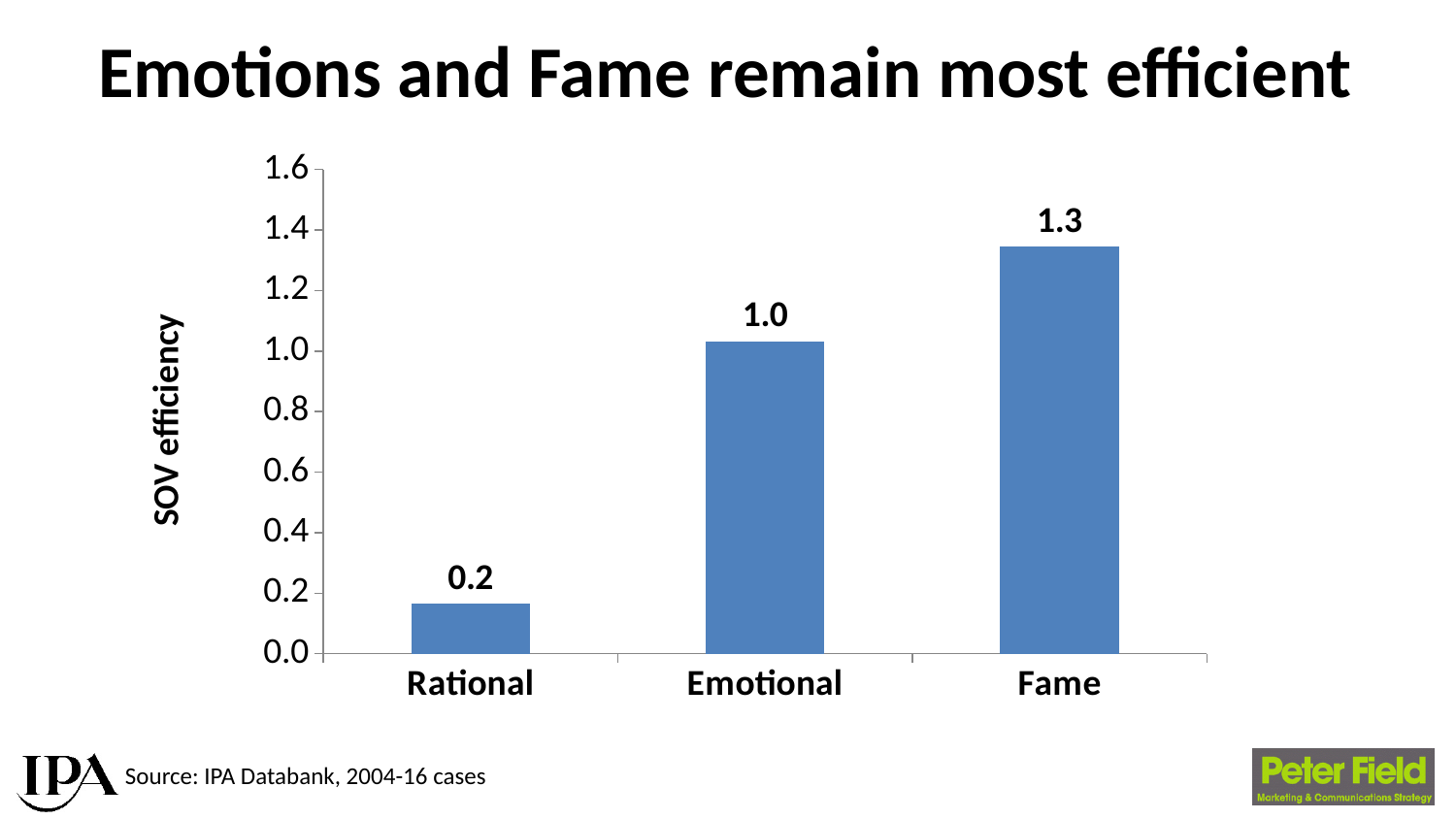
How many categories are shown on the x axis? 3 What is the SOV efficiency value for Fame? 1.3 What is the difference in SOV efficiency between Fame and Rational? 1.1 Which category has the lowest SOV efficiency? Rational What is the SOV efficiency value for Emotional? 1.0 Is the value for Fame greater or less than 1.2? greater What kind of chart is shown on the slide? Bar chart What is the SOV efficiency value for Rational? 0.2 Which has a higher SOV efficiency, Emotional or Rational? Emotional Which category has the highest SOV efficiency? Fame What is the label of the vertical axis? SOV efficiency What is the difference in SOV efficiency between Fame and Emotional? 0.3